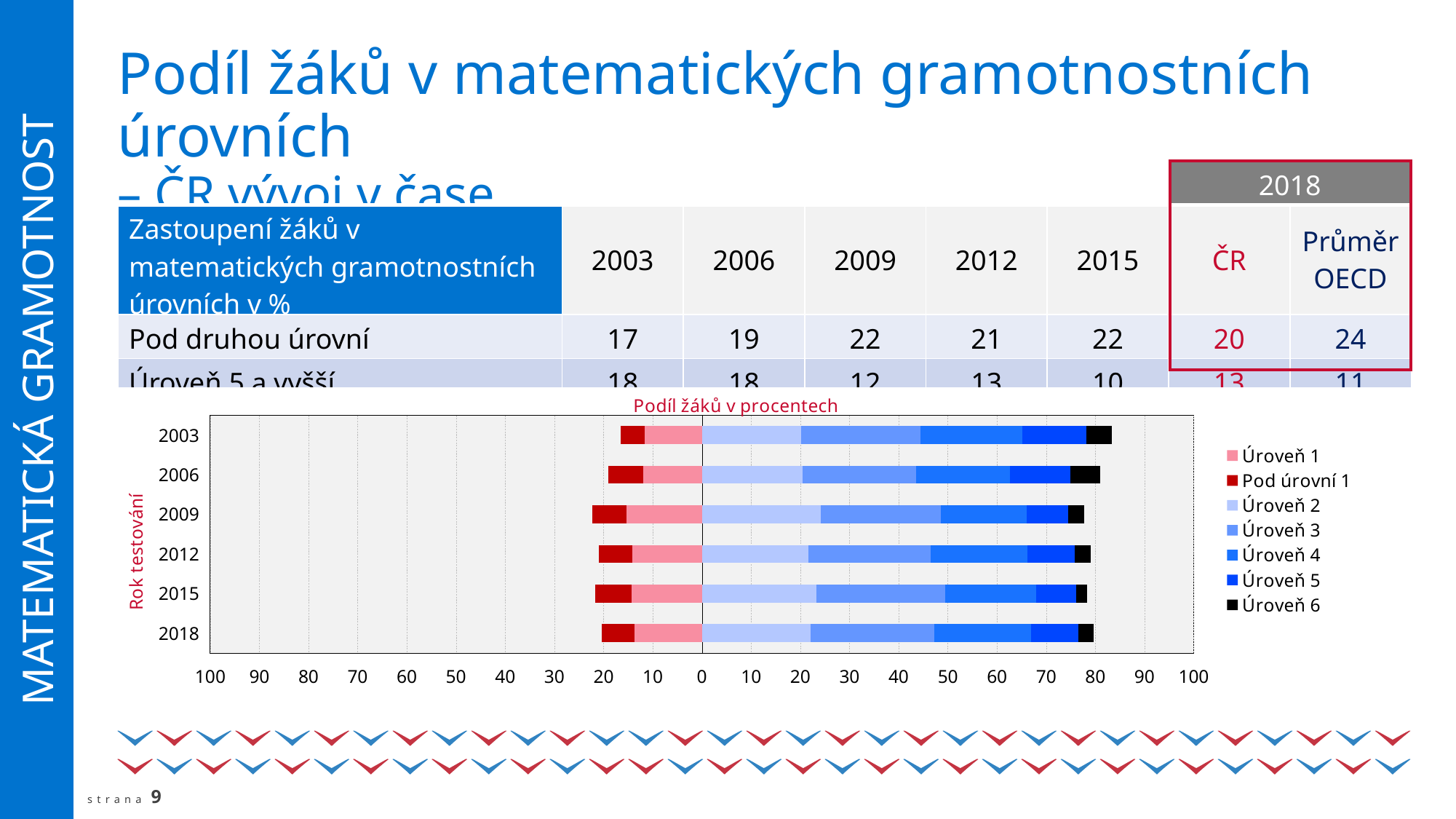
In the chart, does the bar for 2003 extend to the left of zero (below level 2) by more or less than 20? less In the chart, is the Úroveň 6 segment larger for 2003 or for 2009? 2003 What is the title of the chart? Podíl žáků v procentech In the chart, is the Úroveň 1 segment for 2003 greater or less than 20? less What kind of chart is shown on the slide? bar chart In the chart, does the bar for 2003 extend to the right of zero (level 2 and above) by more or less than 80? greater How many years (categories) are plotted on the chart's vertical axis? 6 How many series does the chart's legend list? 7 What is the label of the chart's vertical axis? Rok testování